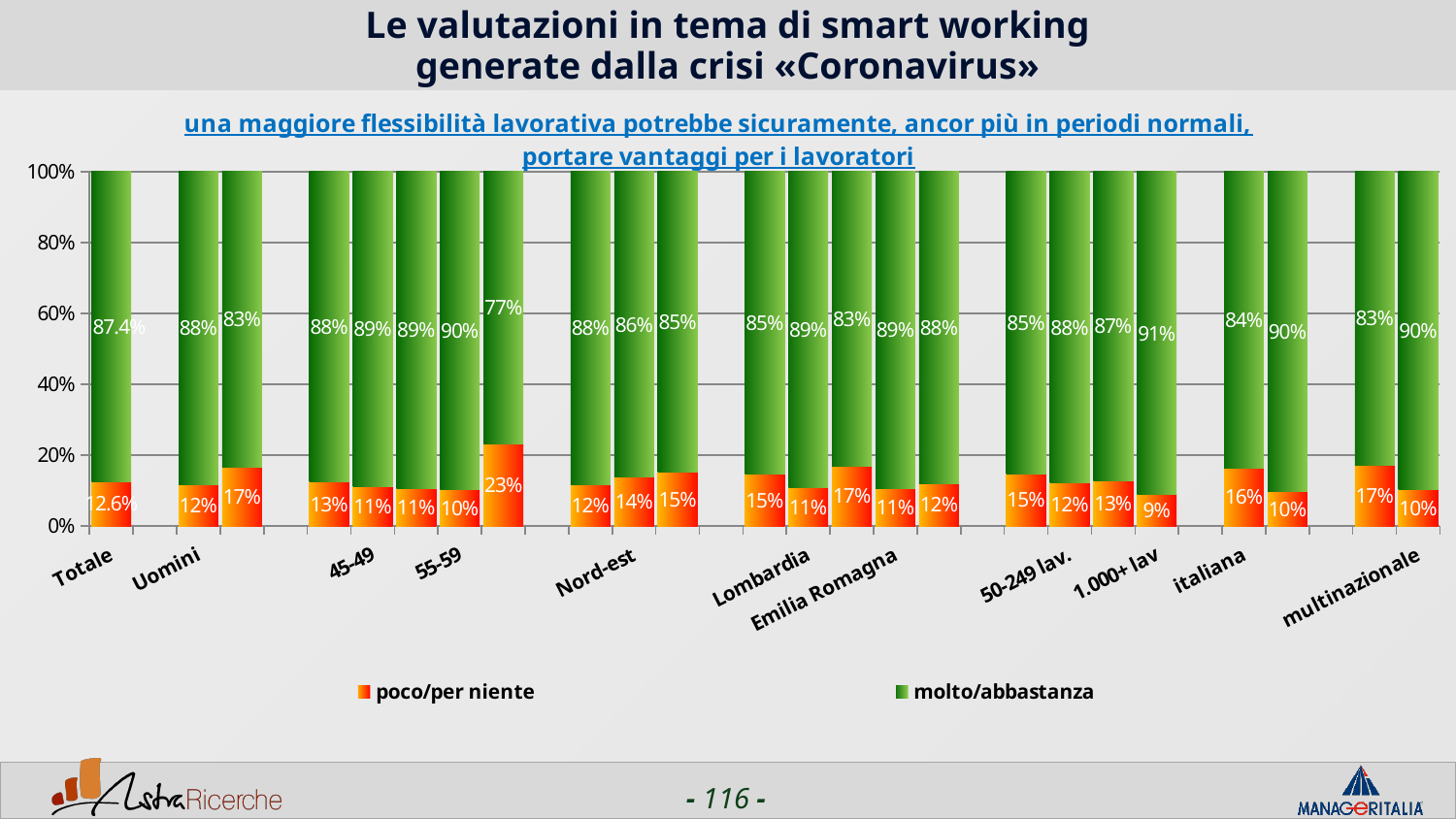
What is the total of the stacked bar for Totale? 100% What are the two series named in the legend? poco/per niente and molto/abbastanza What is the molto/abbastanza value for Totale? 87.4% What is the molto/abbastanza value for Uomini? 88% What is the lowest molto/abbastanza value shown on the chart? 77% How many series does the legend list? 2 Which colour represents the molto/abbastanza series? green Is the molto/abbastanza value for Totale greater or less than 80%? greater What is the highest poco/per niente value shown on the chart? 23% What is the poco/per niente value for Uomini? 12% What kind of chart is shown on the slide? bar chart What is the poco/per niente value for Totale? 12.6%